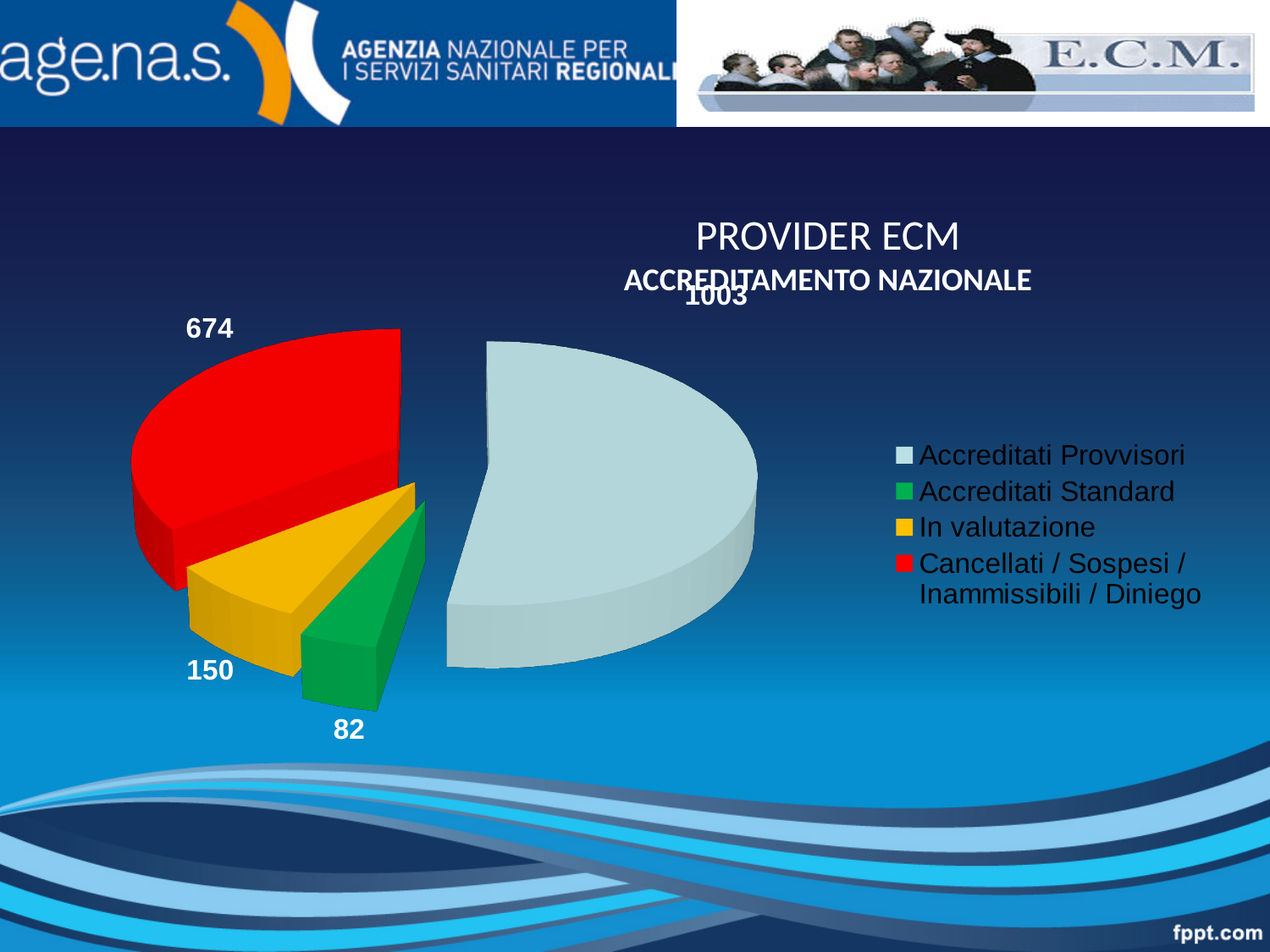
What is the value for In valutazione? 150 Which category has the smallest slice of the pie? Accreditati Standard Which category has the largest slice of the pie? Accreditati Provvisori How many categories does the pie chart show? 4 What is the value for Accreditati Provvisori? 1003 What is the total of all the slices in the pie chart? 1909 What is the difference between the values for Accreditati Provvisori and Cancellati / Sospesi / Inammissibili / Diniego? 329 What colour is the slice for Cancellati / Sospesi / Inammissibili / Diniego? Red What is the value for Accreditati Standard? 82 What is the value for Cancellati / Sospesi / Inammissibili / Diniego? 674 Which is larger, the value for In valutazione or the value for Accreditati Standard? In valutazione What kind of chart is shown on the slide? Pie chart